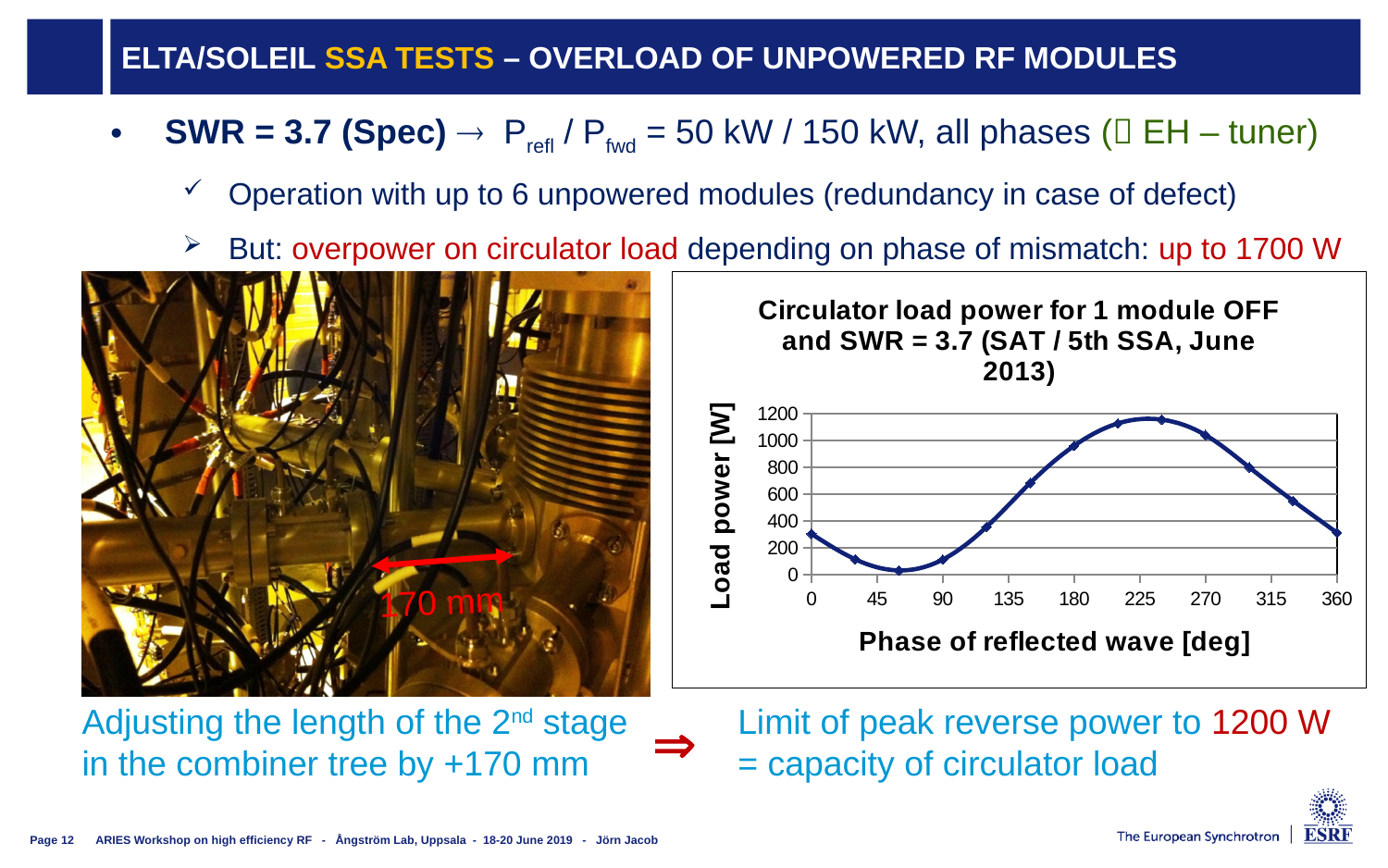
What is the label of the x axis of the chart? Phase of reflected wave [deg] Does the load power rise or fall as the phase increases from 90 deg to 225 deg? rise Is the load power at a phase of 90 deg greater or less than 200 W? less Is the load power at a phase of 240 deg greater or less than 1000 W? greater Which is larger, the load power at 0 deg or at 225 deg? 225 deg Which is larger, the load power at 180 deg or at 90 deg? 180 deg Is the load power at a phase of 0 deg greater or less than 200 W? greater What is the title of the chart? Circulator load power for 1 module OFF and SWR = 3.7 (SAT / 5th SSA, June 2013) Does the load power rise or fall as the phase increases from 270 deg to 360 deg? fall What kind of chart is shown on the slide? line chart